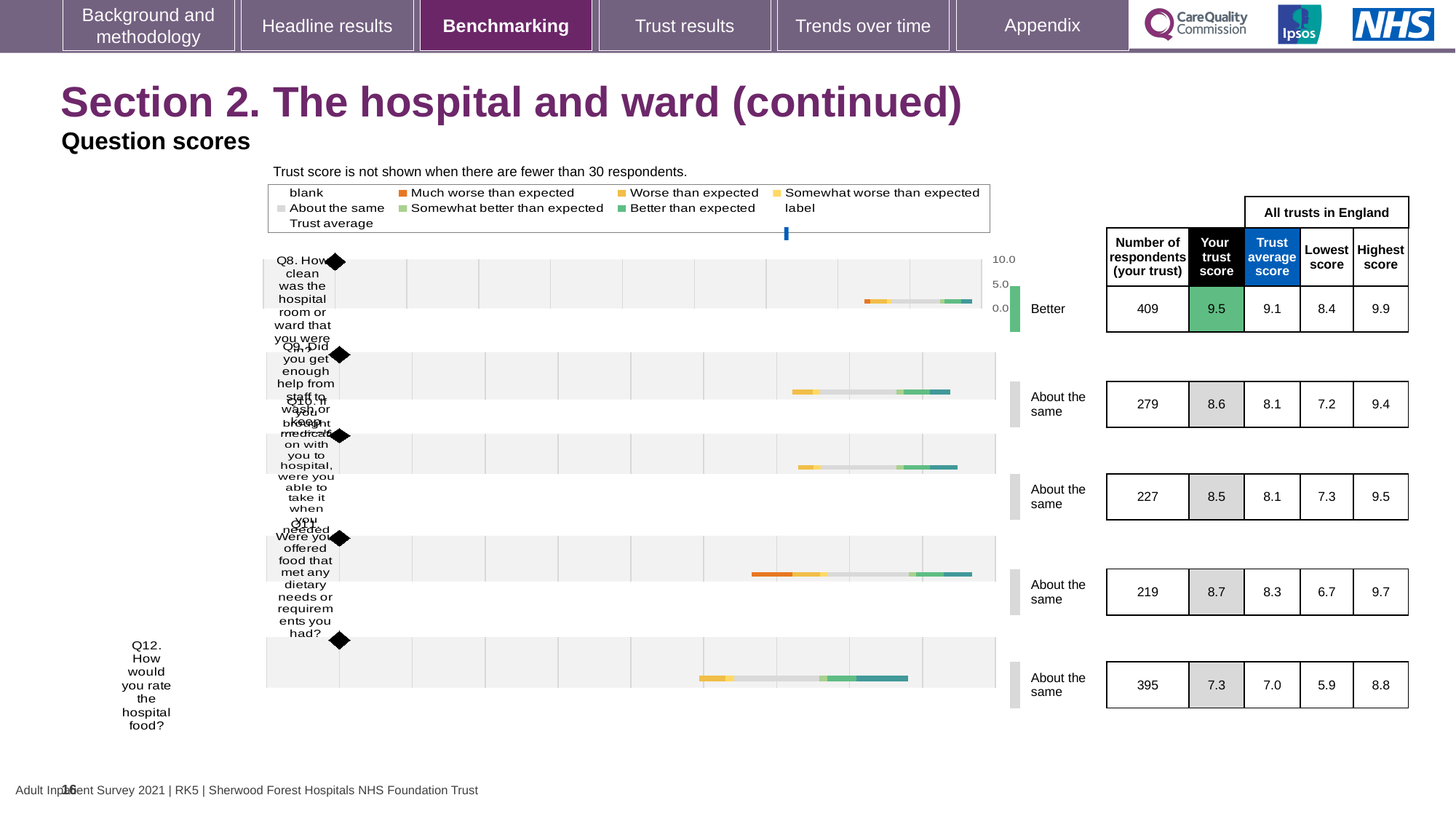
How many respondents does the table show for Q8 (how clean was the hospital room or ward)? 409 What is the trust average score for Q11? 8.3 For Q8, what is the difference between the trust's score and the trust average score? 0.4 What kind of chart is used to show the question scores? Bar chart What benchmark category is shown for Q8? Better How many questions are plotted on this slide's chart? 5 Which has the higher trust score, Q9 or Q10? Q9 Which question has the lowest 'Your trust score' on this slide? Q12 Which question has the highest 'Your trust score' on this slide? Q8 What is the highest score across all trusts in England for Q11? 9.7 What is the lowest score across all trusts in England for Q12? 5.9 What is the trust's score for Q12 (how would you rate the hospital food)? 7.3